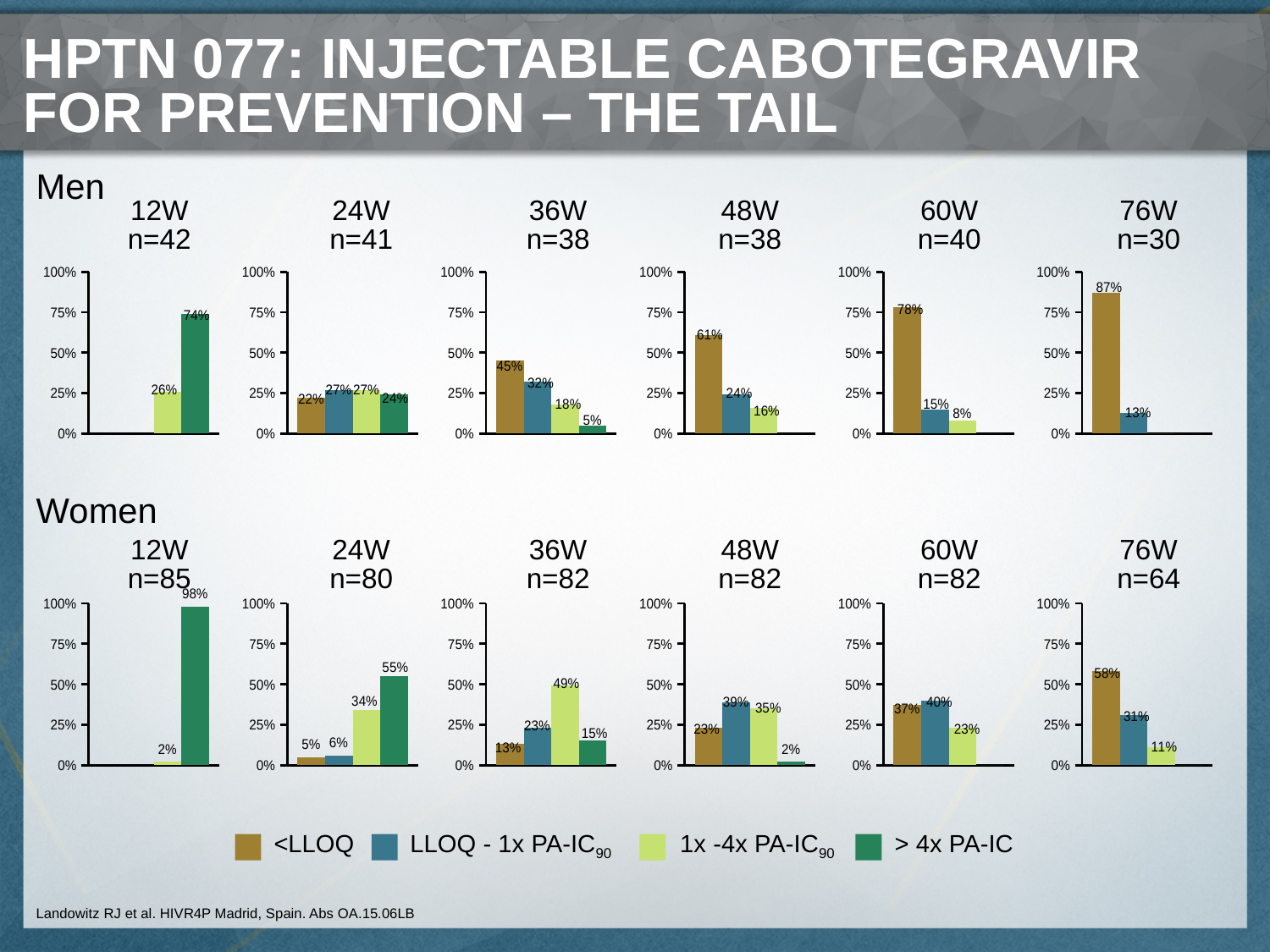
Across the Men charts from 12W to 76W, does the <LLOQ value rise or fall over time? rise In the Men 76W (n=30) chart, what is the value for <LLOQ? 87% In the Women 48W (n=82) chart, which is larger: the <LLOQ value or the LLOQ - 1x PA-IC90 value? LLOQ - 1x PA-IC90 In the Men 36W (n=38) chart, what is the value for LLOQ - 1x PA-IC90? 32% In the Men 60W (n=40) chart, is the value for <LLOQ greater or less than 75%? greater In the Women 24W (n=80) chart, what is the difference between the > 4x PA-IC value and the 1x -4x PA-IC90 value? 21% In the Women 12W (n=85) chart, what is the value for > 4x PA-IC? 98% What kind of chart is used for the Men 24W (n=41) panel? bar chart In the Women 36W (n=82) chart, which category has the highest value? 1x -4x PA-IC90 How many series does the legend list? 4 In the Women 76W (n=64) chart, how many bars are plotted? 3